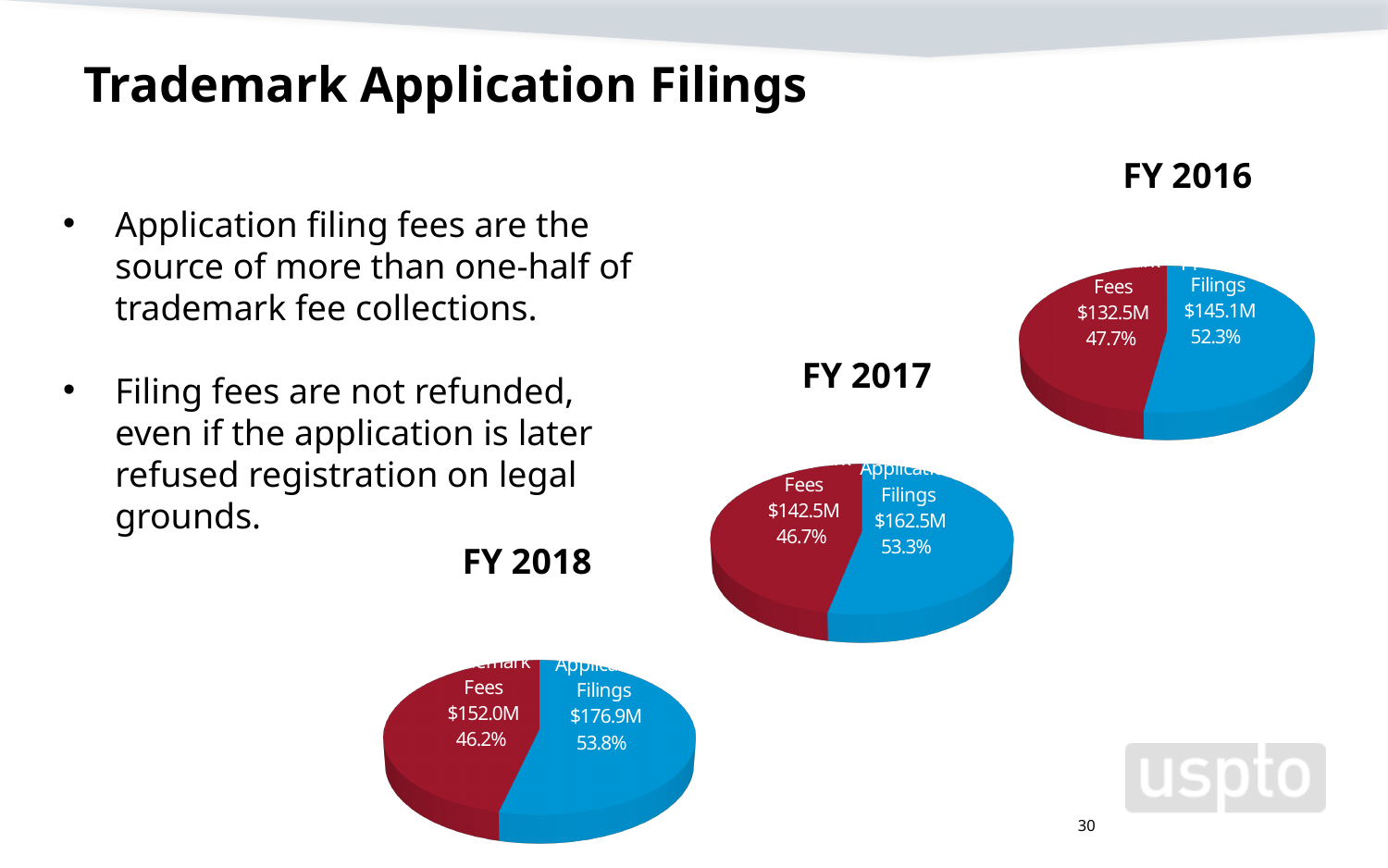
In the FY 2018 pie chart, what share of the pie does the Filings slice represent? 53.8% How many pie charts are shown on the slide? 3 In the FY 2016 pie chart, what is the value shown for the Fees slice? $132.5M In the FY 2017 pie chart, what is the value shown for the Filings slice? $162.5M In the FY 2017 pie chart, which slice is larger, Fees or Filings? Filings In the FY 2016 pie chart, what is the value shown for the Filings slice? $145.1M In the FY 2018 pie chart, what is the value shown for the Fees slice? $152.0M What kind of chart is used for FY 2016, FY 2017 and FY 2018? Pie chart In the FY 2017 pie chart, what share of the pie does the Fees slice represent? 46.7% In the FY 2018 pie chart, what is the difference between the Filings value and the Fees value? $24.9M How many slices does the FY 2018 pie chart have? 2 In the FY 2016 pie chart, what share of the pie does the Filings slice represent? 52.3%